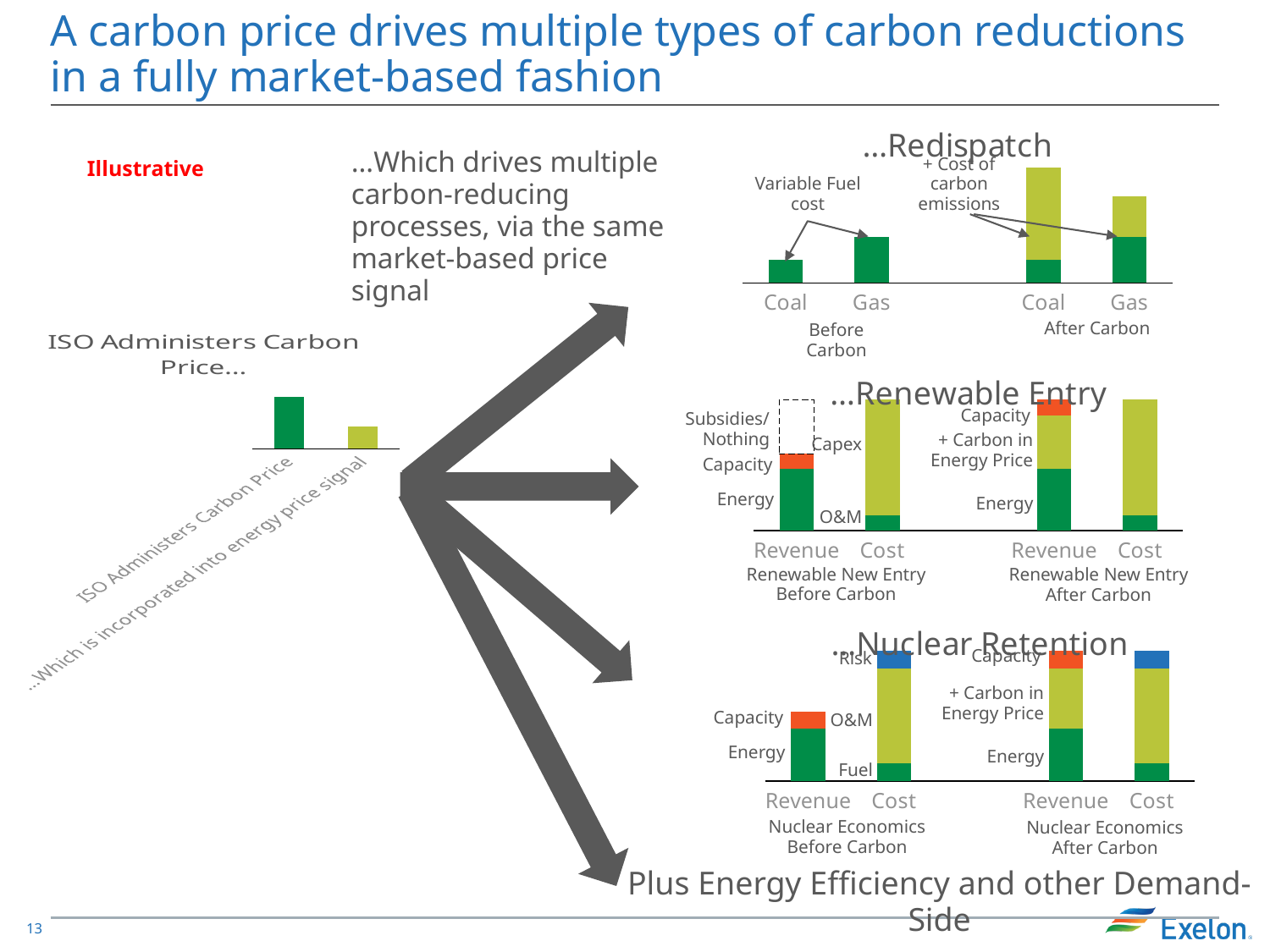
In the Nuclear Retention chart, which bar is taller in the Nuclear Economics Before Carbon group, Revenue or Cost? Cost What kind of chart is the Redispatch chart? bar chart How many bars are plotted in the Redispatch chart? 4 What are the two category labels on the x axis of the Renewable Entry chart for each group? Revenue and Cost In the Redispatch chart, what does the green portion of each bar represent? Variable Fuel cost What kind of chart is the Nuclear Retention chart? bar chart In the Redispatch chart, which bar is taller in the Before Carbon group, Coal or Gas? Gas In the Redispatch chart, what does the light green portion added in the After Carbon bars represent? Cost of carbon emissions In the Redispatch chart, which bar is taller in the After Carbon group, Coal or Gas? Coal How many bars are shown in the ISO Administers Carbon Price chart? 2